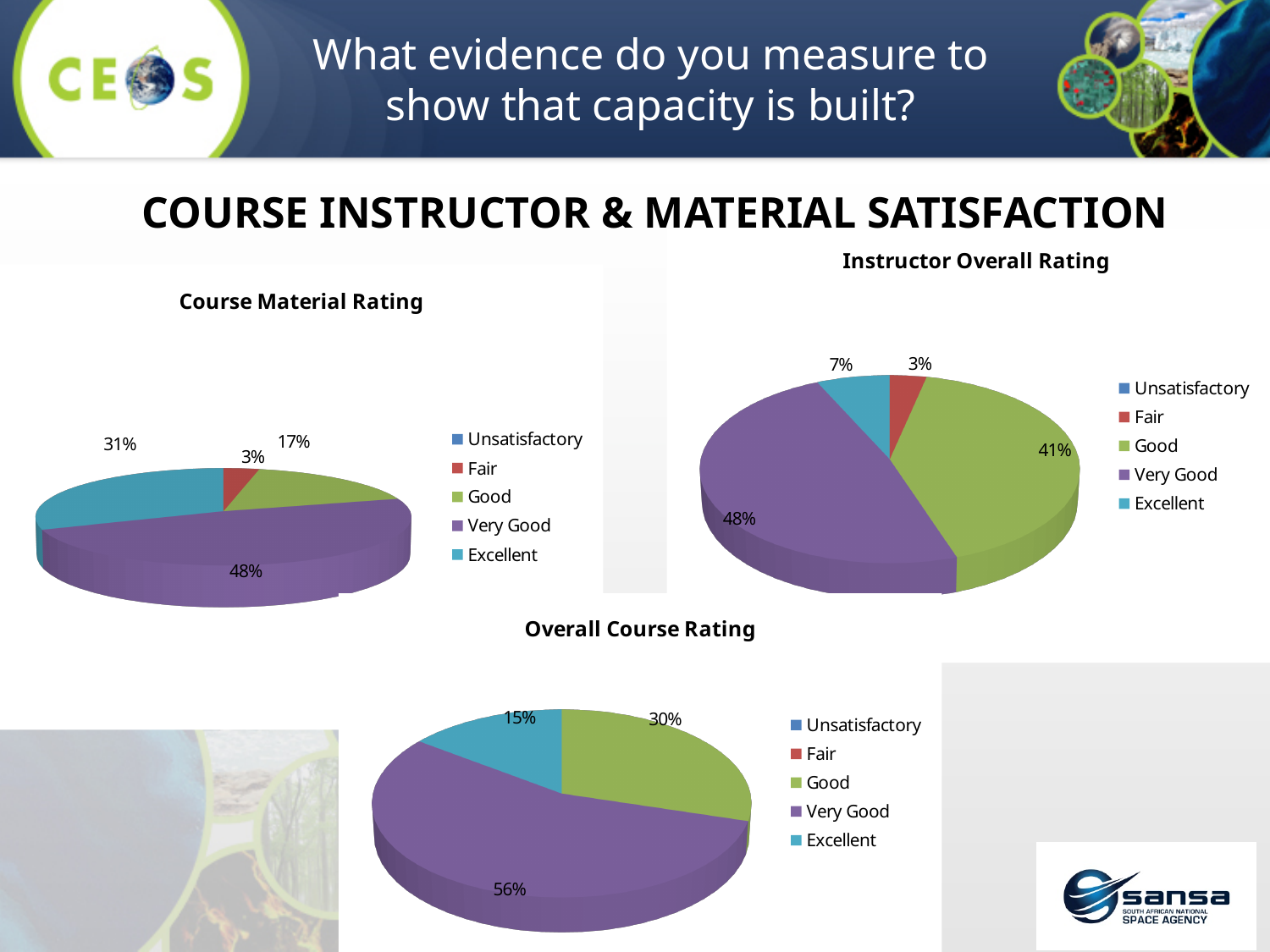
In the Overall Course Rating chart, which is larger, Good or Excellent? Good In the Course Material Rating chart, what share of responses is Very Good? 48% In the Overall Course Rating chart, which category has the largest slice? Very Good In the Instructor Overall Rating chart, what share of responses is Good? 41% In the Overall Course Rating chart, what share of responses is Very Good? 56% What kind of chart is the Overall Course Rating chart? Pie chart How many entries does the legend of the Instructor Overall Rating chart list? 5 In the Course Material Rating chart, what share of responses is Excellent? 31% In the Instructor Overall Rating chart, what is the difference between the Very Good and Good shares? 7% In the Instructor Overall Rating chart, what share of responses is Excellent? 7% In the Course Material Rating chart, what is the combined share of Very Good and Excellent? 79% In the Course Material Rating chart, which labelled category has the smallest slice? Fair